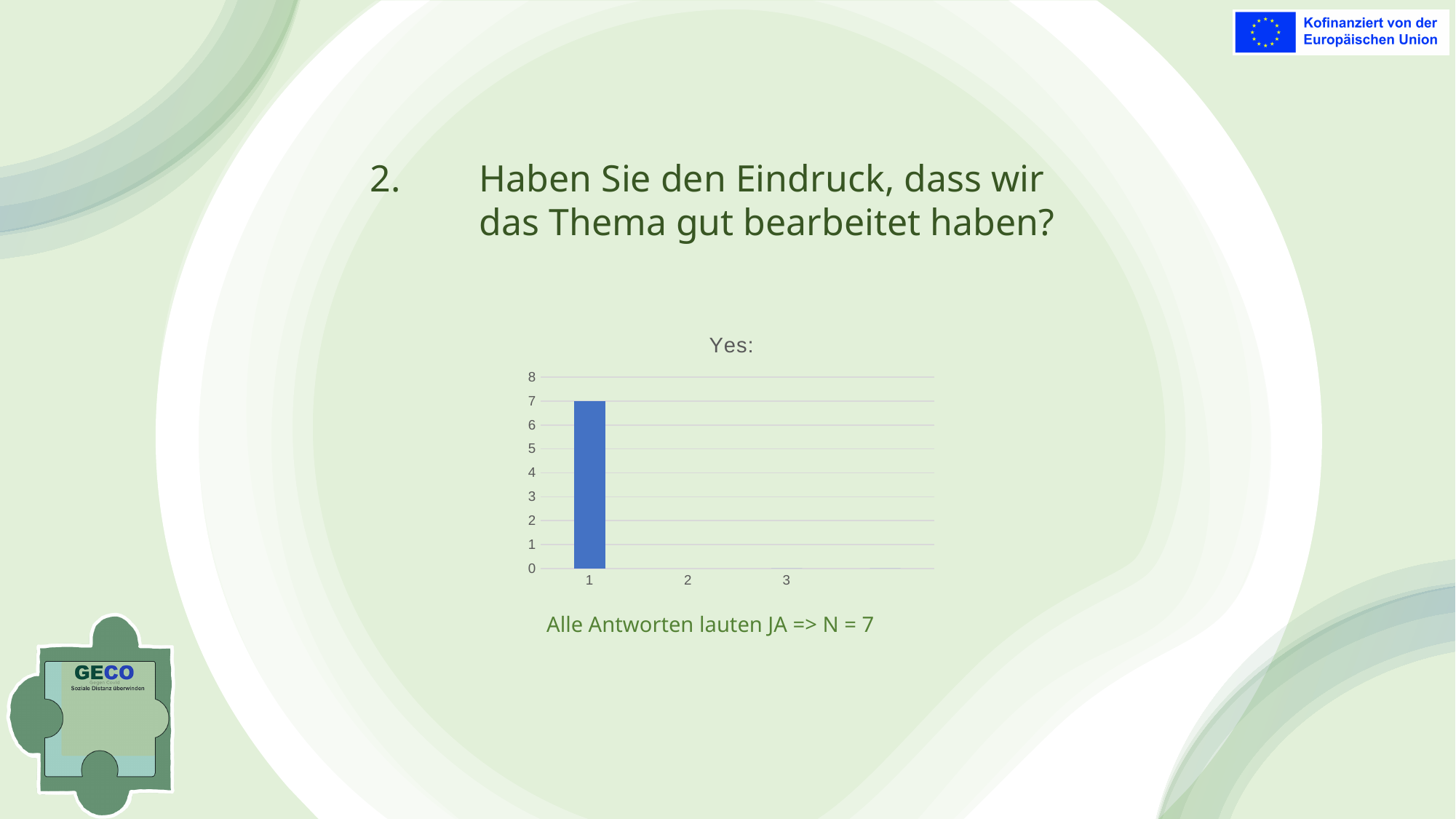
What is the highest value shown on the y axis? 8 How many categories are labelled on the x axis? 3 Is the value for category 1 greater or less than 8? less What is the title of the chart? Yes: Which category has the highest bar? 1 How many bars are visibly plotted in the chart? 1 What kind of chart is shown on the slide? bar chart Is the value for category 1 greater or less than 5? greater Is the bar for category 1 taller than any bar for category 2? yes What is the value of the bar for category 1? 7